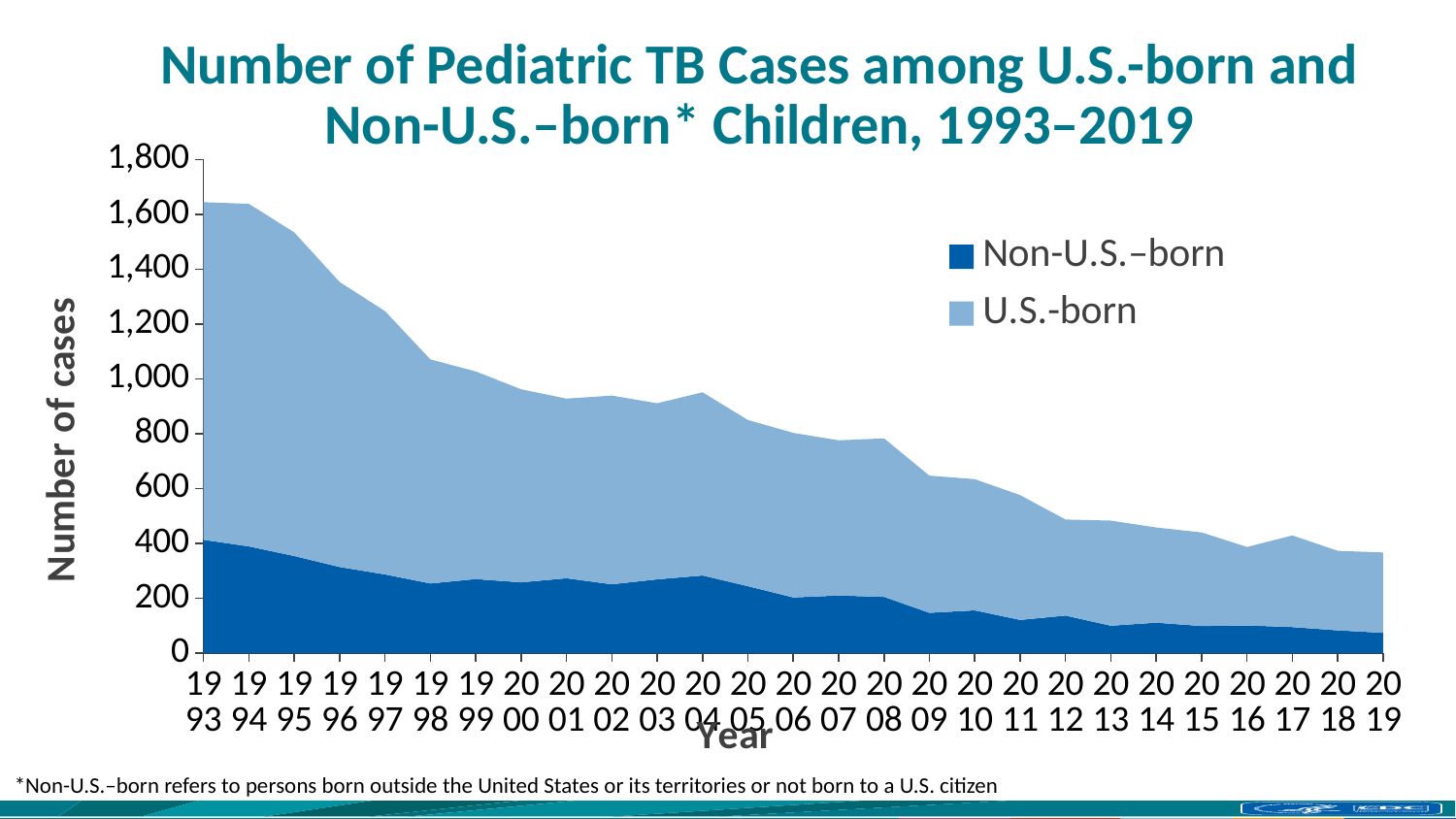
Is the number of Non-U.S.-born cases in 1993 greater or less than 200? greater What kind of chart is shown on the slide? Stacked area chart Is the total number of cases in 1993 greater or less than 1,400? greater Is the total number of cases in 2019 greater or less than 600? less How many years are plotted along the x axis? 27 How many series does the legend list? 2 What is the label on the vertical axis? Number of cases Do the total number of pediatric TB cases rise or fall from 1993 to 2019? Fall Which series is shown in dark blue in the legend? Non-U.S.-born